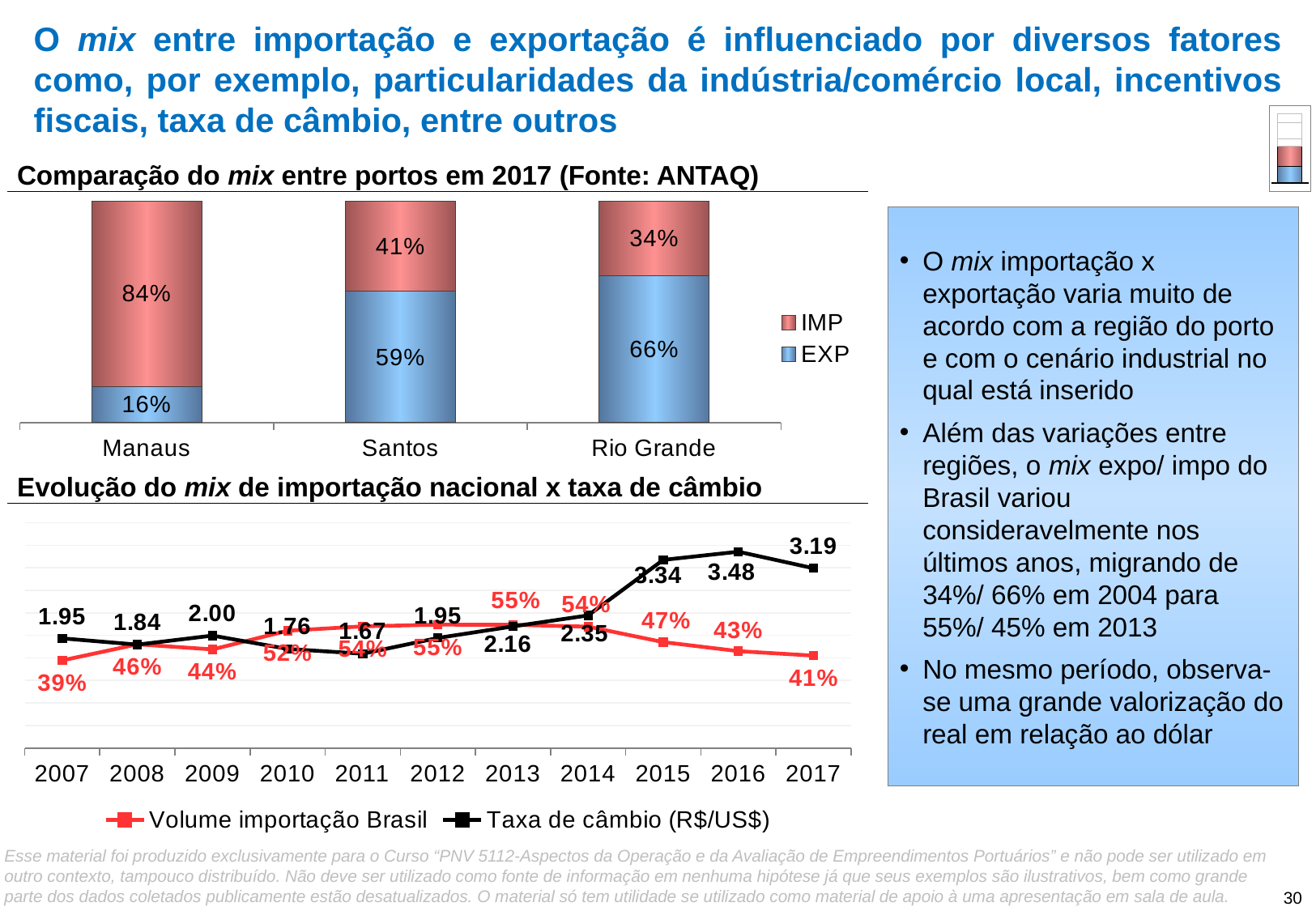
In the chart 'Comparação do mix entre portos em 2017', which port has the lowest IMP share? Rio Grande In the chart 'Evolução do mix de importação nacional x taxa de câmbio', does the Taxa de câmbio (R$/US$) rise or fall from 2014 to 2016? Rise In the chart 'Evolução do mix de importação nacional x taxa de câmbio', how many years are shown on the x axis? 11 In the chart 'Evolução do mix de importação nacional x taxa de câmbio', what is the Taxa de câmbio (R$/US$) value for 2016? 3.48 In the chart 'Evolução do mix de importação nacional x taxa de câmbio', in which year is the Taxa de câmbio (R$/US$) lowest? 2011 In the chart 'Comparação do mix entre portos em 2017', what is the difference between the EXP share of Santos and the EXP share of Manaus? 43% In the chart 'Comparação do mix entre portos em 2017', which port has the highest EXP share? Rio Grande In the chart 'Comparação do mix entre portos em 2017', what is the IMP share for Manaus? 84% In the chart 'Comparação do mix entre portos em 2017', what is the EXP share for Rio Grande? 66% In the chart 'Evolução do mix de importação nacional x taxa de câmbio', what is the Volume importação Brasil value for 2007? 39% In the chart 'Comparação do mix entre portos em 2017', how many series does the legend list? 2 What kind of chart is 'Comparação do mix entre portos em 2017'? Stacked bar chart